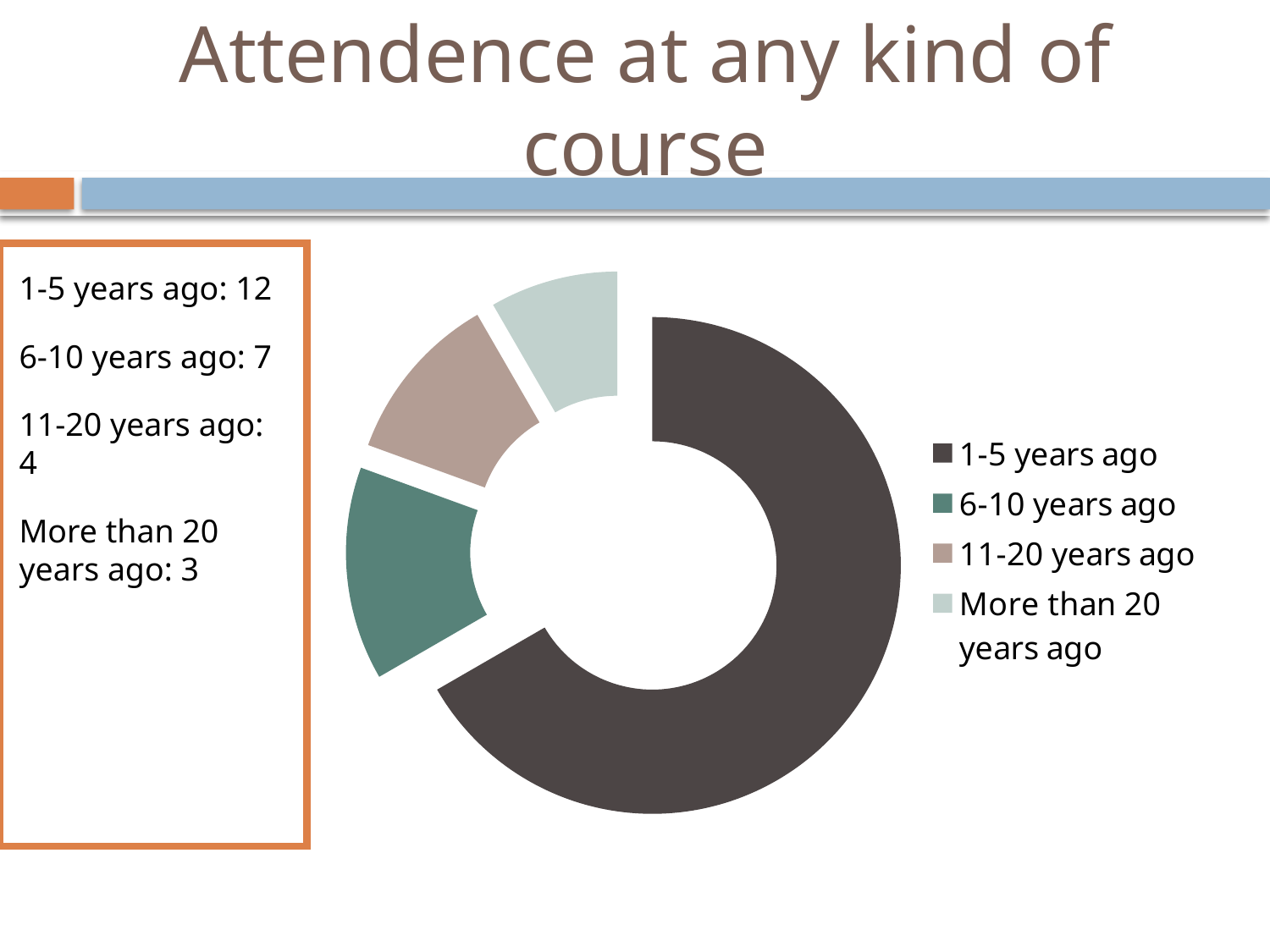
Which is larger, the value for 11-20 years ago or the value for More than 20 years ago? 11-20 years ago Which category has the largest share of the chart? 1-5 years ago What is the title of the slide containing the chart? Attendence at any kind of course What value is shown for 1-5 years ago? 12 Which category has the smallest share of the chart? More than 20 years ago What value is shown for 6-10 years ago? 7 How many categories does the chart show? 4 What is the total of all four values shown? 26 What kind of chart is shown on the slide? Doughnut chart What is the difference between the values for 1-5 years ago and 6-10 years ago? 5 What value is shown for 11-20 years ago? 4 What value is shown for More than 20 years ago? 3